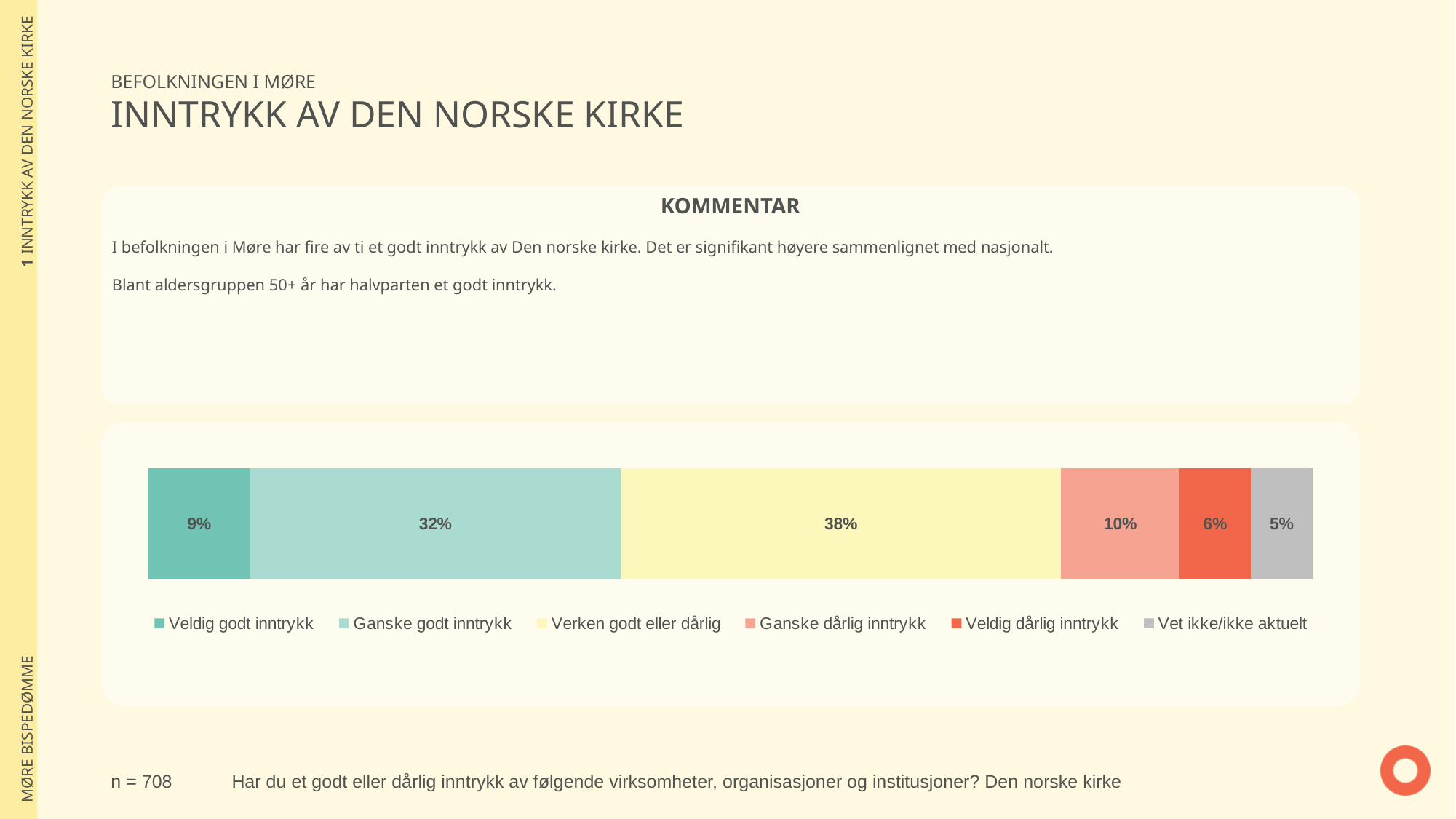
How many response categories does the legend list? 6 Which is larger, the share for "Veldig godt inntrykk" or for "Veldig dårlig inntrykk"? Veldig godt inntrykk What percentage of respondents answered "Veldig godt inntrykk"? 9% What kind of chart is shown on the slide? Stacked bar chart What is the difference between the shares for "Ganske godt inntrykk" and "Ganske dårlig inntrykk"? 22 percentage points What percentage of respondents answered "Verken godt eller dårlig"? 38% What percentage of respondents answered "Vet ikke/ikke aktuelt"? 5% What is the combined share of "Veldig godt inntrykk" and "Ganske godt inntrykk"? 41% What percentage of respondents answered "Ganske godt inntrykk"? 32% What colour is the segment for "Veldig dårlig inntrykk"? Red Which response category has the largest share? Verken godt eller dårlig Which response category has the smallest share? Vet ikke/ikke aktuelt